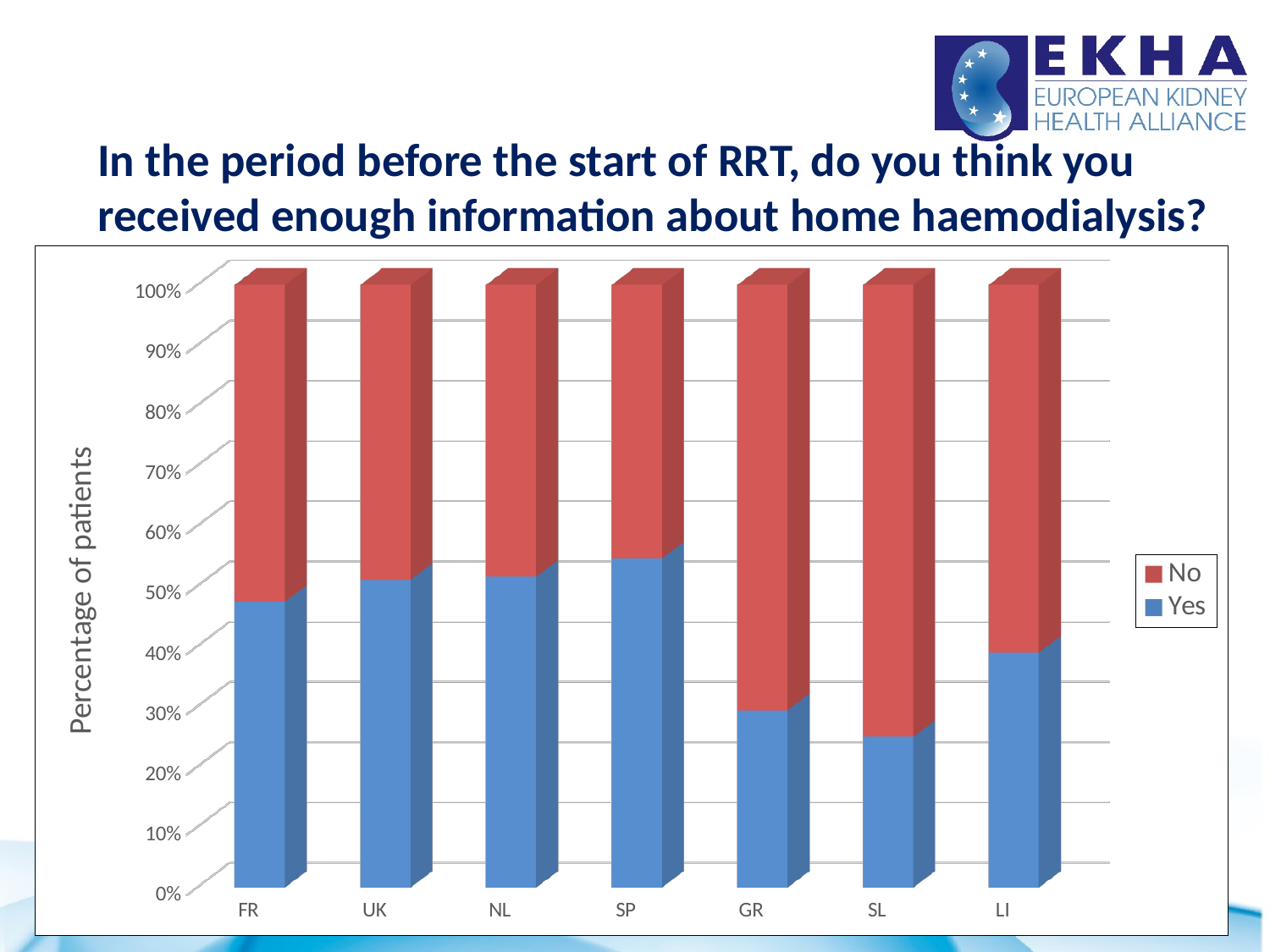
How many countries are shown on the x axis of the chart? 7 Which country has the largest share of 'No' responses? SL Which country has the highest share of 'Yes' responses? SP How many series does the chart's legend list? 2 Is the 'Yes' value for GR greater or less than 40%? less Is the 'Yes' value for SP greater or less than 50%? greater What is the label of the chart's vertical axis? Percentage of patients Which country has a larger share of 'Yes' responses, UK or SL? UK What kind of chart is shown on the slide? stacked bar chart Which country has the lowest share of 'Yes' responses? SL Which country has a larger share of 'Yes' responses, FR or LI? FR Is the 'Yes' value for SL greater or less than 30%? less